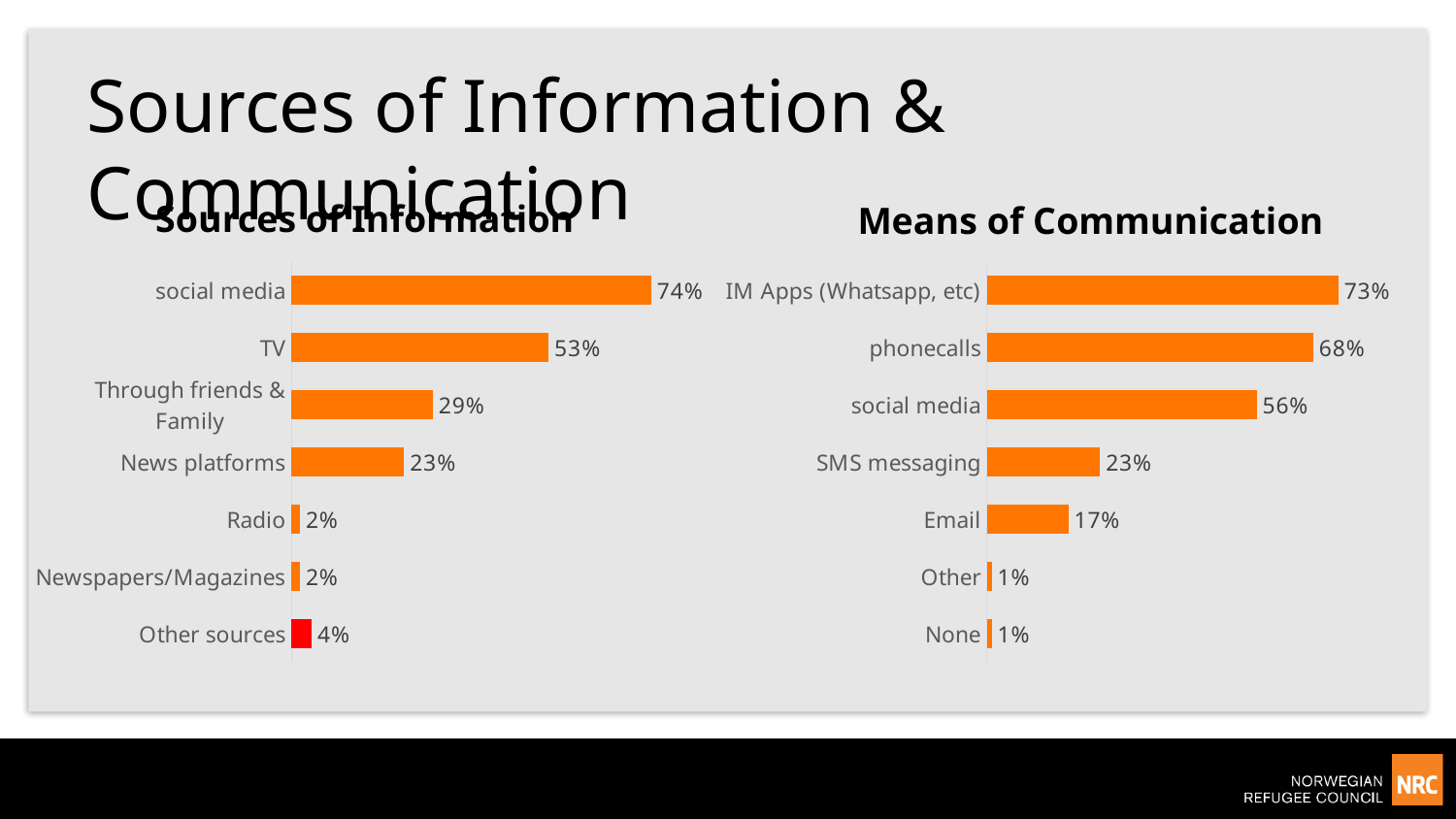
In the Sources of Information chart, which bar is coloured red rather than orange? Other sources In the Sources of Information chart, what is the difference between social media and TV? 21% In the Means of Communication chart, what is the value for phonecalls? 68% In the Means of Communication chart, which is larger: phonecalls or SMS messaging? phonecalls How many categories are shown in the Means of Communication chart? 7 In the Means of Communication chart, which category has the lowest value among those above 1%? Email How many categories are shown in the Sources of Information chart? 7 In the Sources of Information chart, what is the value for TV? 53% In the Sources of Information chart, which is larger: News platforms or Through friends & Family? Through friends & Family In the Sources of Information chart, which category has the highest value? social media What type of chart is the Means of Communication chart? bar chart In the Means of Communication chart, what is the difference between IM Apps (Whatsapp, etc) and social media? 17%